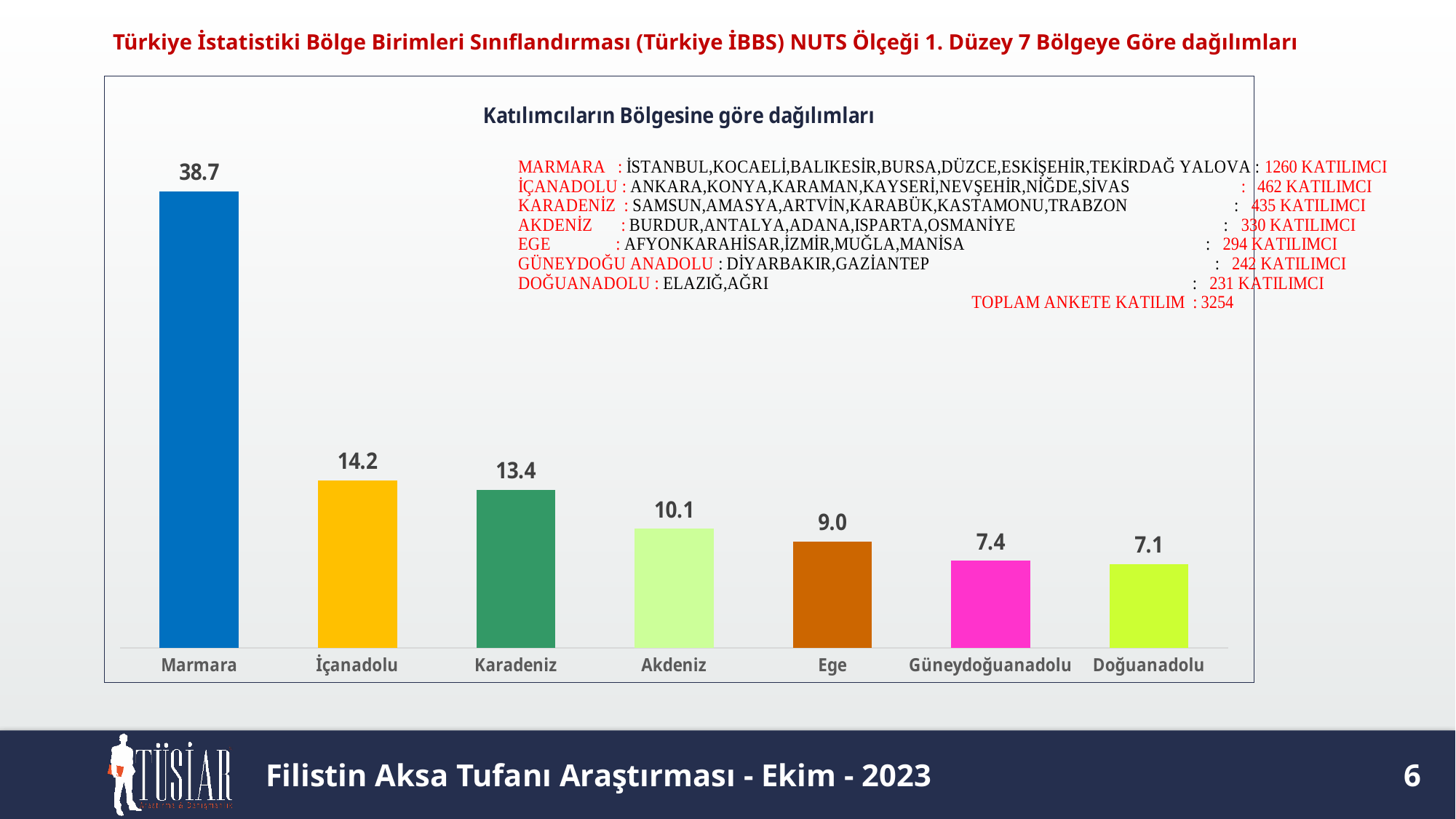
What kind of chart is shown on the slide? Bar chart Which region has the highest value? Marmara What is the value for Marmara? 38.7 What is the difference between the values for Akdeniz and Ege? 1.1 What is the title of the chart? Katılımcıların Bölgesine göre dağılımları Which region has the lowest value? Doğuanadolu How many regions are shown in the chart? 7 What is the value for Doğuanadolu? 7.1 What is the difference between the values for Marmara and İçanadolu? 24.5 Which is larger, the value for İçanadolu or the value for Karadeniz? İçanadolu What is the value for Ege? 9.0 What is the value for Karadeniz? 13.4